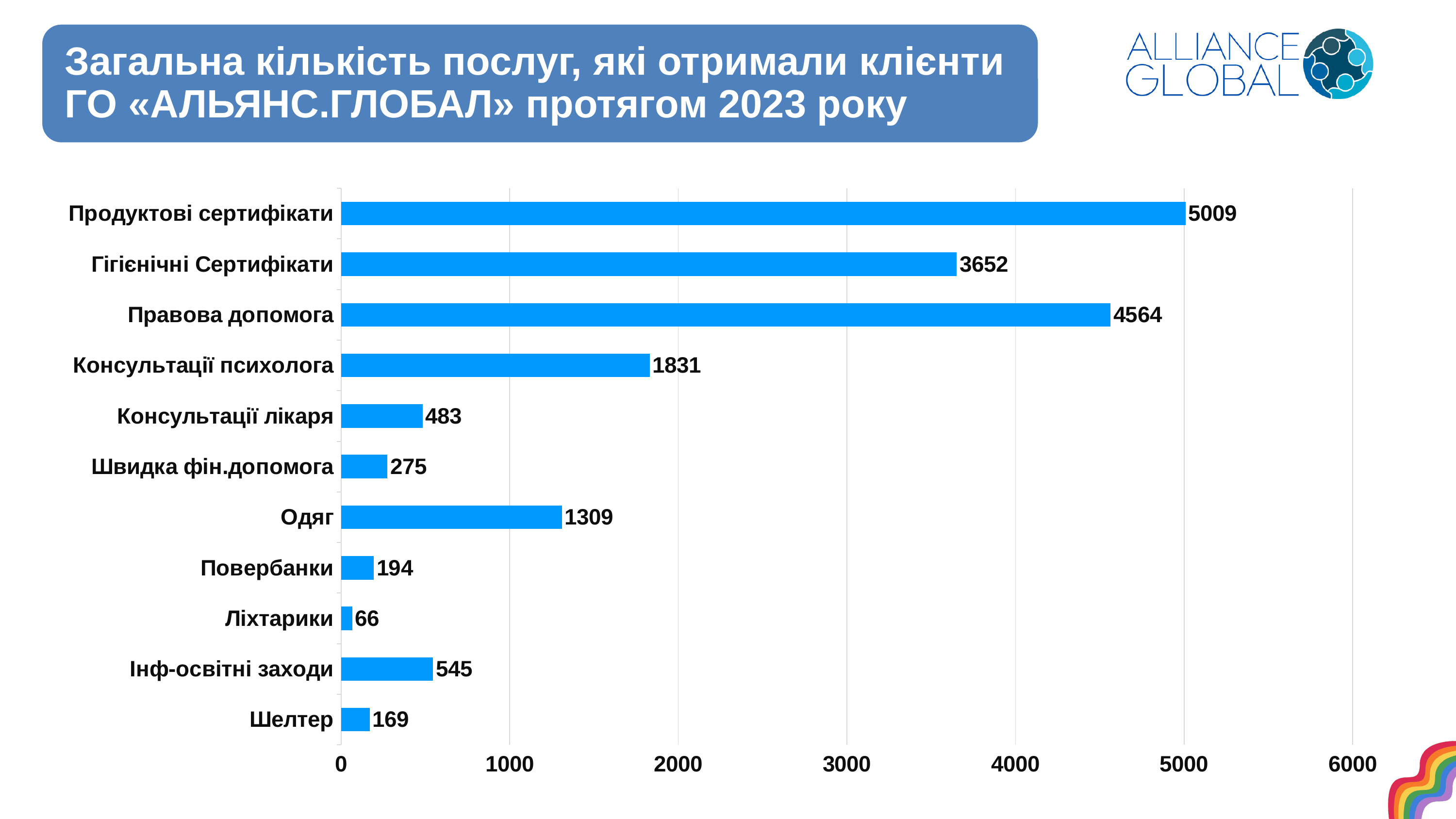
Which is larger, the value for Одяг or the value for Консультації лікаря? Одяг What is the value for Шелтер? 169 What is the value for Консультації психолога? 1831 What is the difference between the values for Продуктові сертифікати and Правова допомога? 445 Which category has the lowest value? Ліхтарики How many categories are plotted in the chart? 11 What type of chart is shown on the slide? bar chart Is the value for Правова допомога greater or less than 4000? greater What is the value for Продуктові сертифікати? 5009 What is the difference between the values for Гігієнічні Сертифікати and Консультації психолога? 1821 Which category has the highest value? Продуктові сертифікати What year does the chart title say the services were received in? 2023